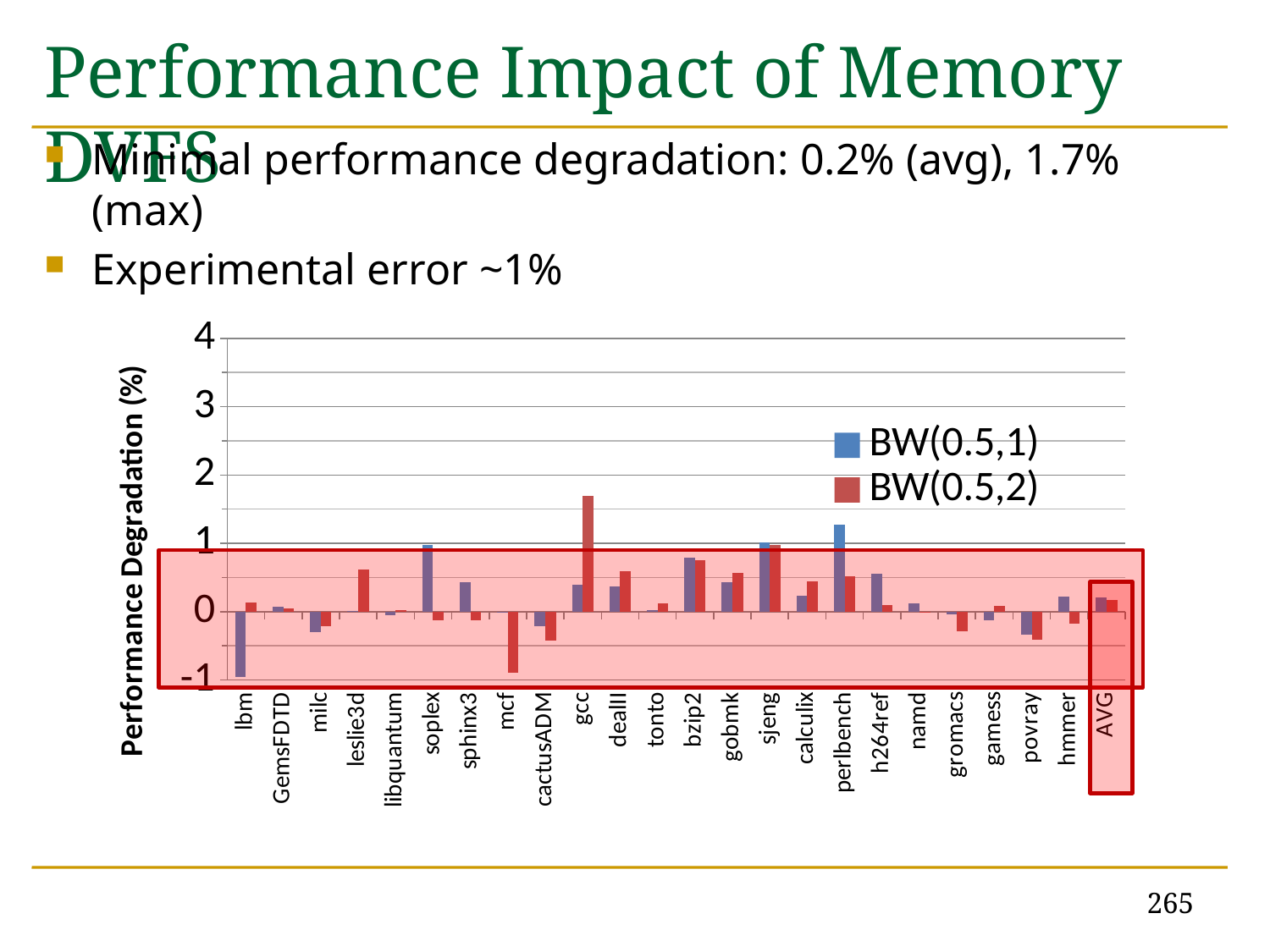
Is the BW(0.5,2) value for gcc greater or less than 1? greater Which category has the highest BW(0.5,2) value? gcc How many categories are shown along the x axis of the chart, including AVG? 24 Which category has the highest BW(0.5,1) value? perlbench How many series does the chart legend list? 2 Which category has the lowest BW(0.5,2) value? mcf What kind of chart is shown on the slide? bar chart Is the BW(0.5,1) value for lbm greater or less than 0? less For gcc, which series has the larger value, BW(0.5,1) or BW(0.5,2)? BW(0.5,2) Which category has the lowest BW(0.5,1) value? lbm What are the two series named in the chart legend? BW(0.5,1) and BW(0.5,2) What is the label of the vertical axis of the chart? Performance Degradation (%)